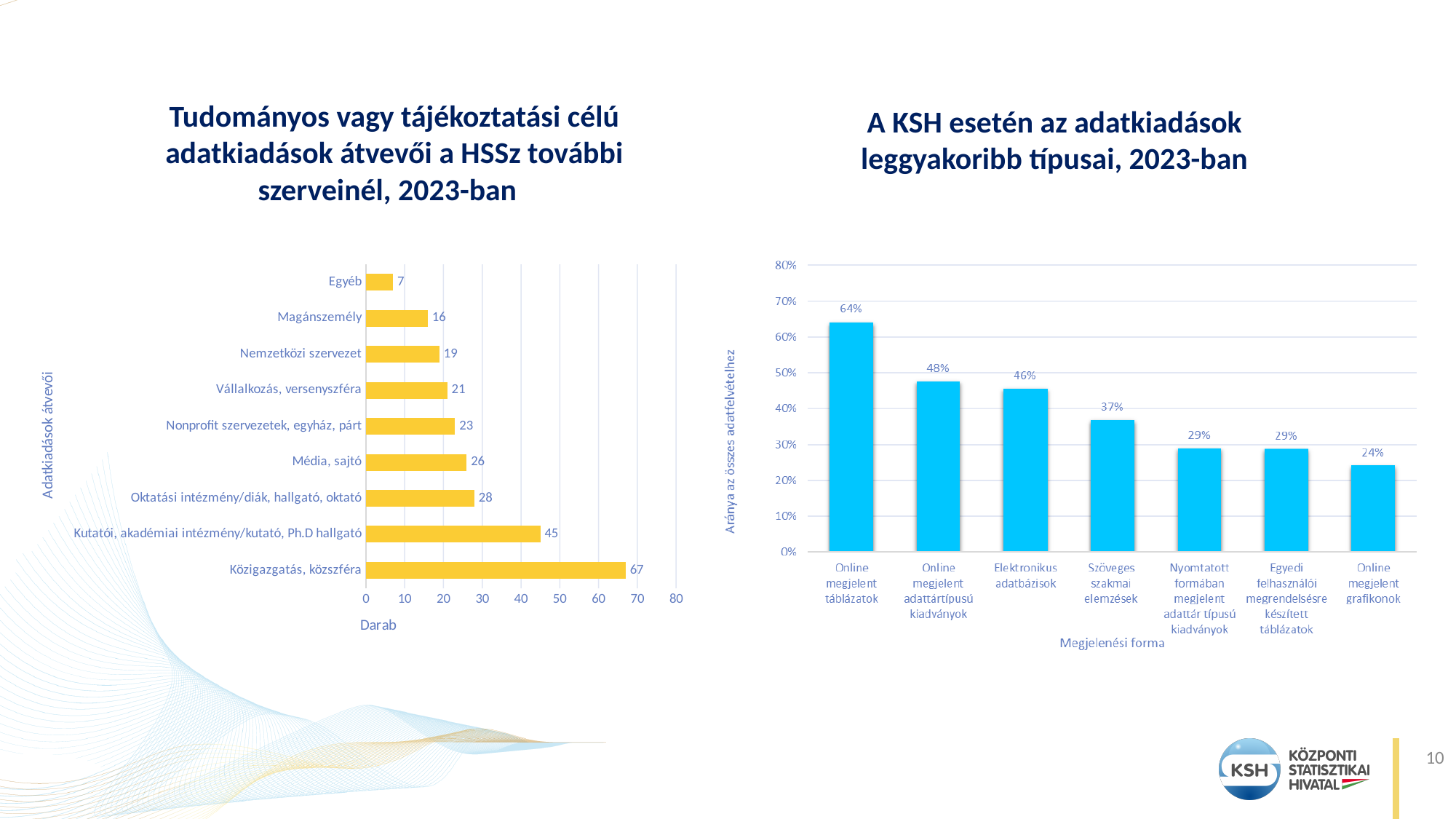
In the right chart, what is the difference between Online megjelent táblázatok and Online megjelent grafikonok? 40% In the right chart, which category has the highest value? Online megjelent táblázatok In the left chart, what is the difference between Közigazgatás, közszféra and Kutatói, akadémiai intézmény/kutató, Ph.D hallgató? 22 In the left chart, which category has the lowest value? Egyéb In the left chart, what is the value for Média, sajtó? 26 In the left chart, which is larger: Magánszemély or Nemzetközi szervezet? Nemzetközi szervezet How many categories are shown in the left chart? 9 How many categories are shown in the right chart? 7 In the left chart (Tudományos vagy tájékoztatási célú adatkiadások átvevői), what is the value for Közigazgatás, közszféra? 67 In the right chart (A KSH esetén az adatkiadások leggyakoribb típusai), what is the value for Szöveges szakmai elemzések? 37% What type of chart is the left chart? Bar chart What is the x-axis title of the right chart? Megjelenési forma